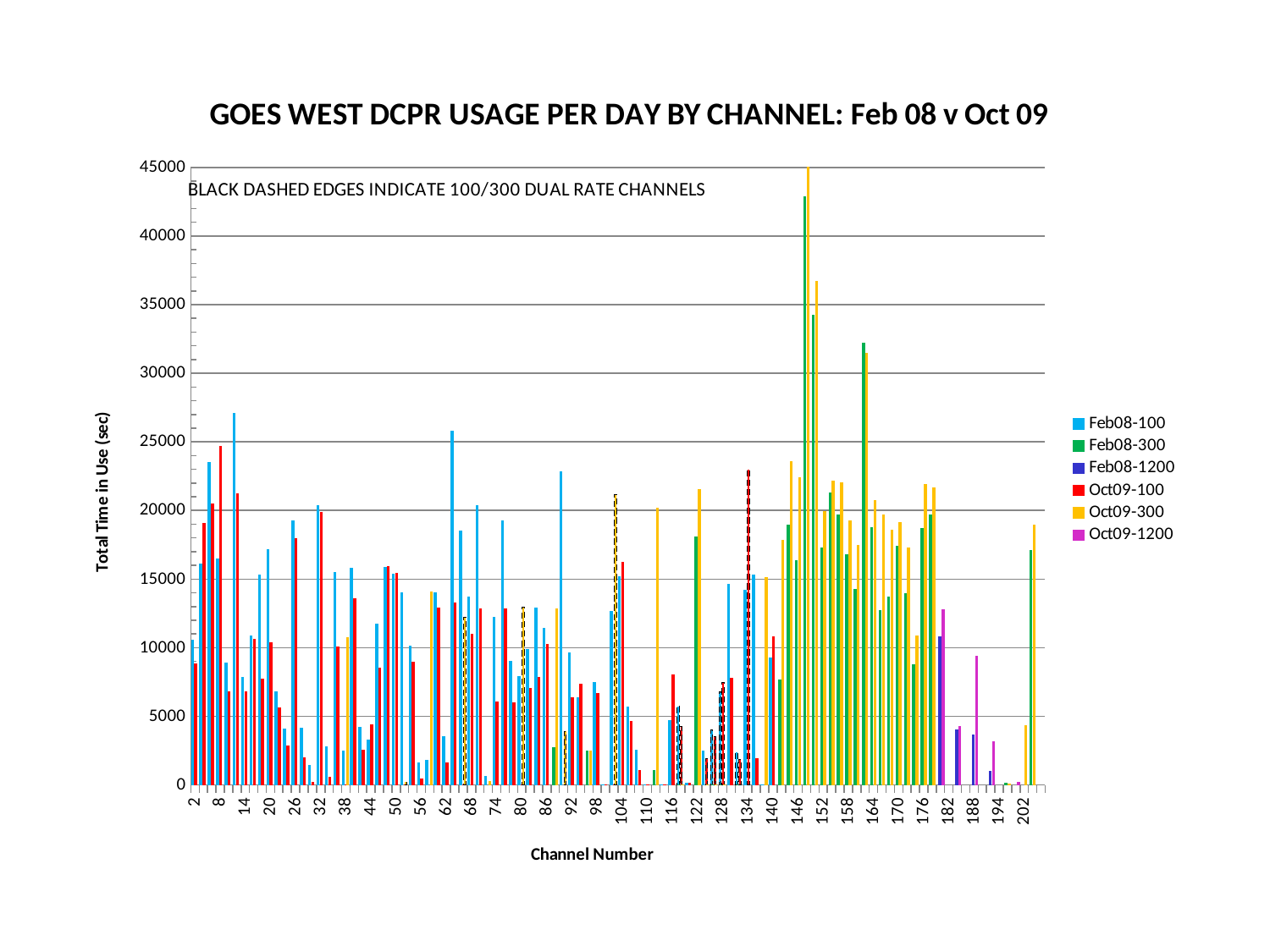
What kind of chart is shown on the slide? bar chart Is the tallest Oct09-1200 bar greater or less than 10000? greater Is the tallest Feb08-1200 bar greater or less than 15000? less Is the tallest Feb08-300 bar greater or less than 40000? greater What is the label of the y axis? Total Time in Use (sec) What is the label of the x axis? Channel Number What is the highest value shown on the y axis? 45000 How many series does the legend list? 6 According to the note on the chart, what do black dashed edges indicate? 100/300 dual rate channels What is the title of the chart? GOES WEST DCPR USAGE PER DAY BY CHANNEL: Feb 08 v Oct 09